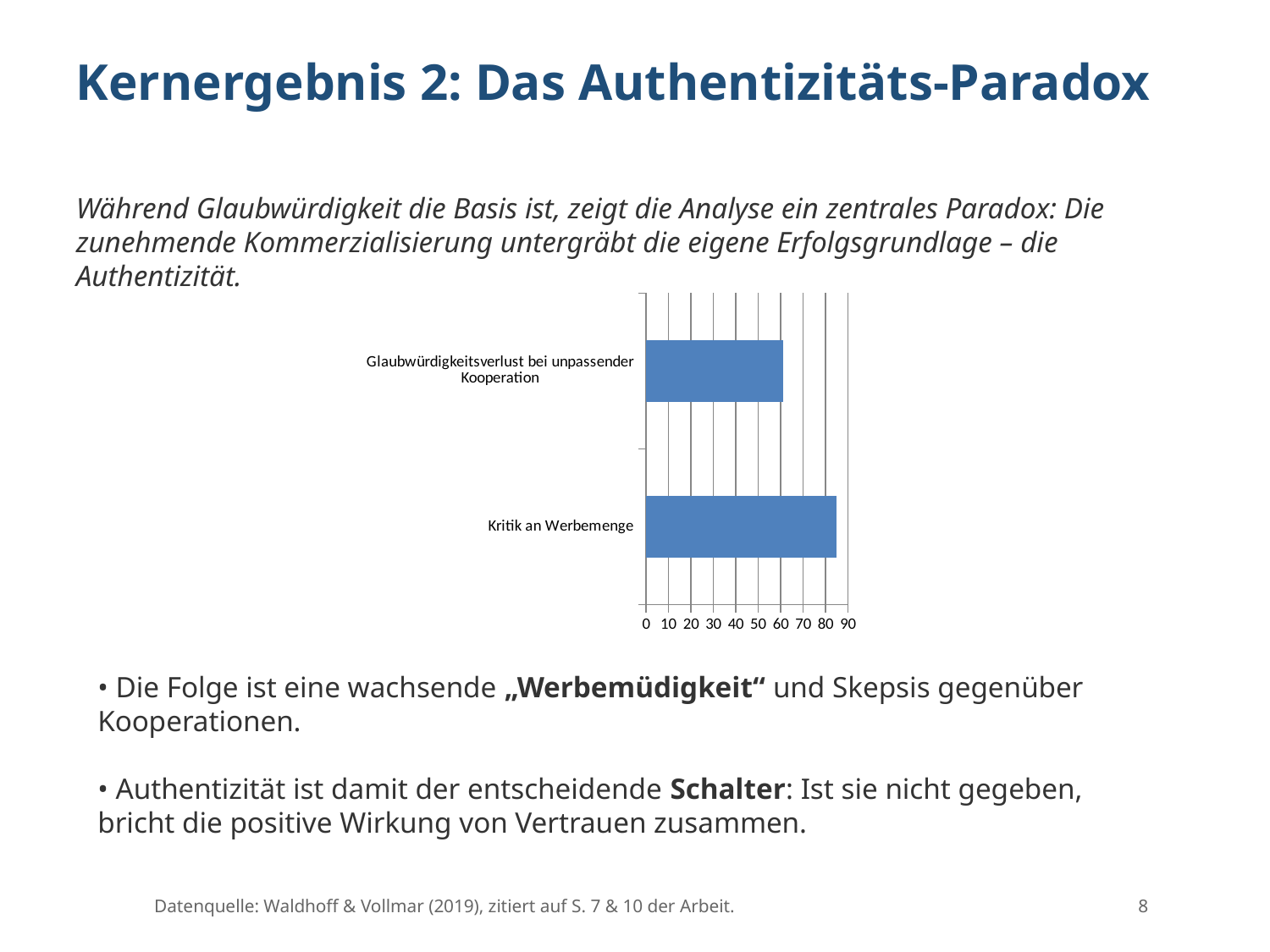
Is the value for Glaubwürdigkeitsverlust bei unpassender Kooperation greater or less than 50? greater Is the value for Kritik an Werbemenge greater or less than 80? greater What is the highest value shown on the chart's horizontal axis? 90 Which category has the lowest value in the chart? Glaubwürdigkeitsverlust bei unpassender Kooperation Which category has the highest value in the chart? Kritik an Werbemenge What colour are the bars in the chart? blue Which is larger: the value for Kritik an Werbemenge or the value for Glaubwürdigkeitsverlust bei unpassender Kooperation? Kritik an Werbemenge Is the value for Kritik an Werbemenge greater or less than 90? less What kind of chart is shown on the slide? bar chart How many categories does the chart show? 2